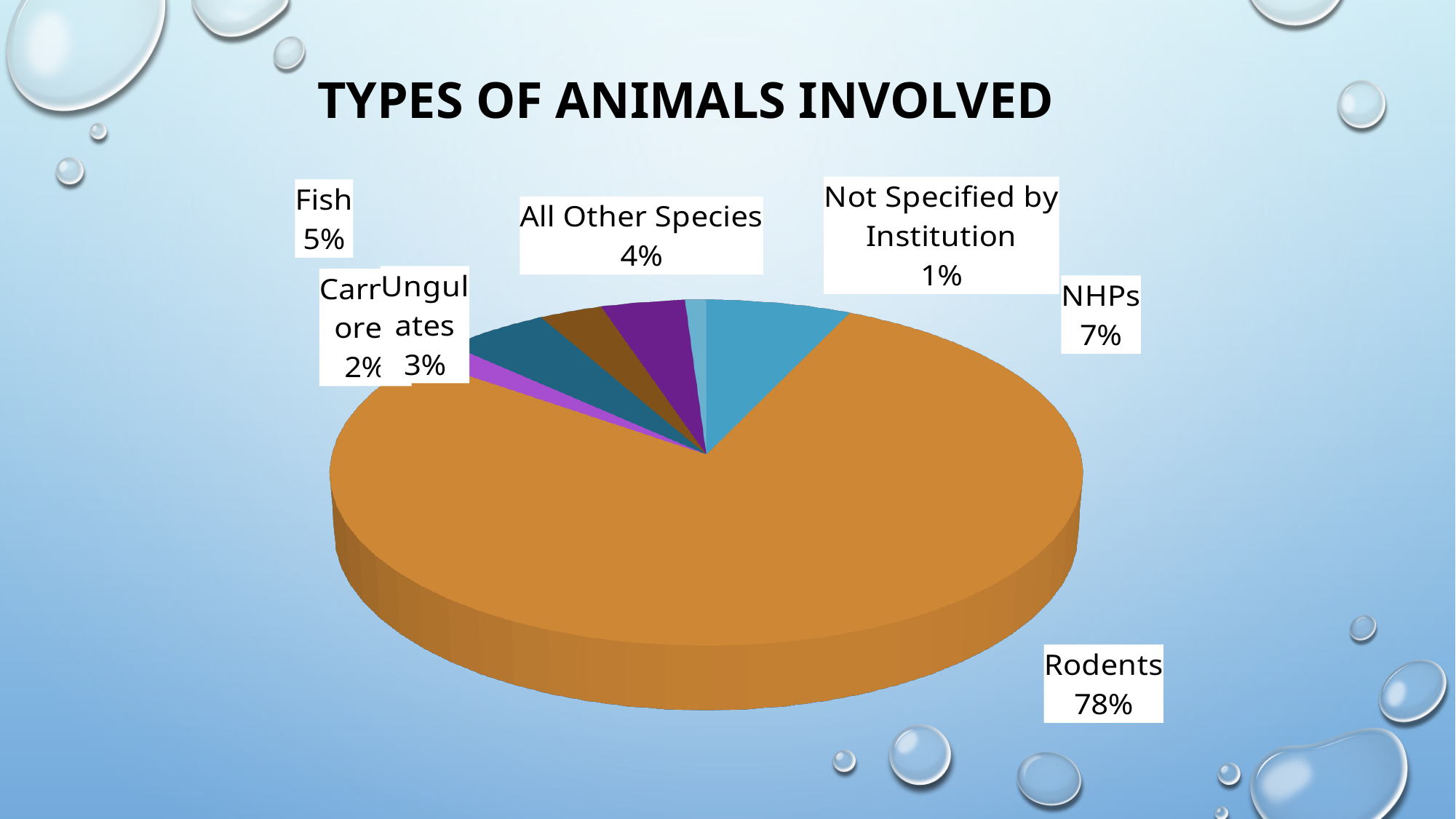
What kind of chart is shown on the slide? Pie chart What percentage is shown for Not Specified by Institution? 1% What percentage is shown for NHPs? 7% What percentage is shown for Fish? 5% How many percentage points larger is the Rodents share than the NHPs share? 71 percentage points What share of the pie do Rodents account for? 78% Which is larger, the share for Fish or the share for NHPs? NHPs Which category has the smallest slice of the pie? Not Specified by Institution What percentage is shown for Ungulates? 3% Which category has the largest slice of the pie? Rodents What is the title of the chart? Types of Animals Involved What percentage is shown for All Other Species? 4%